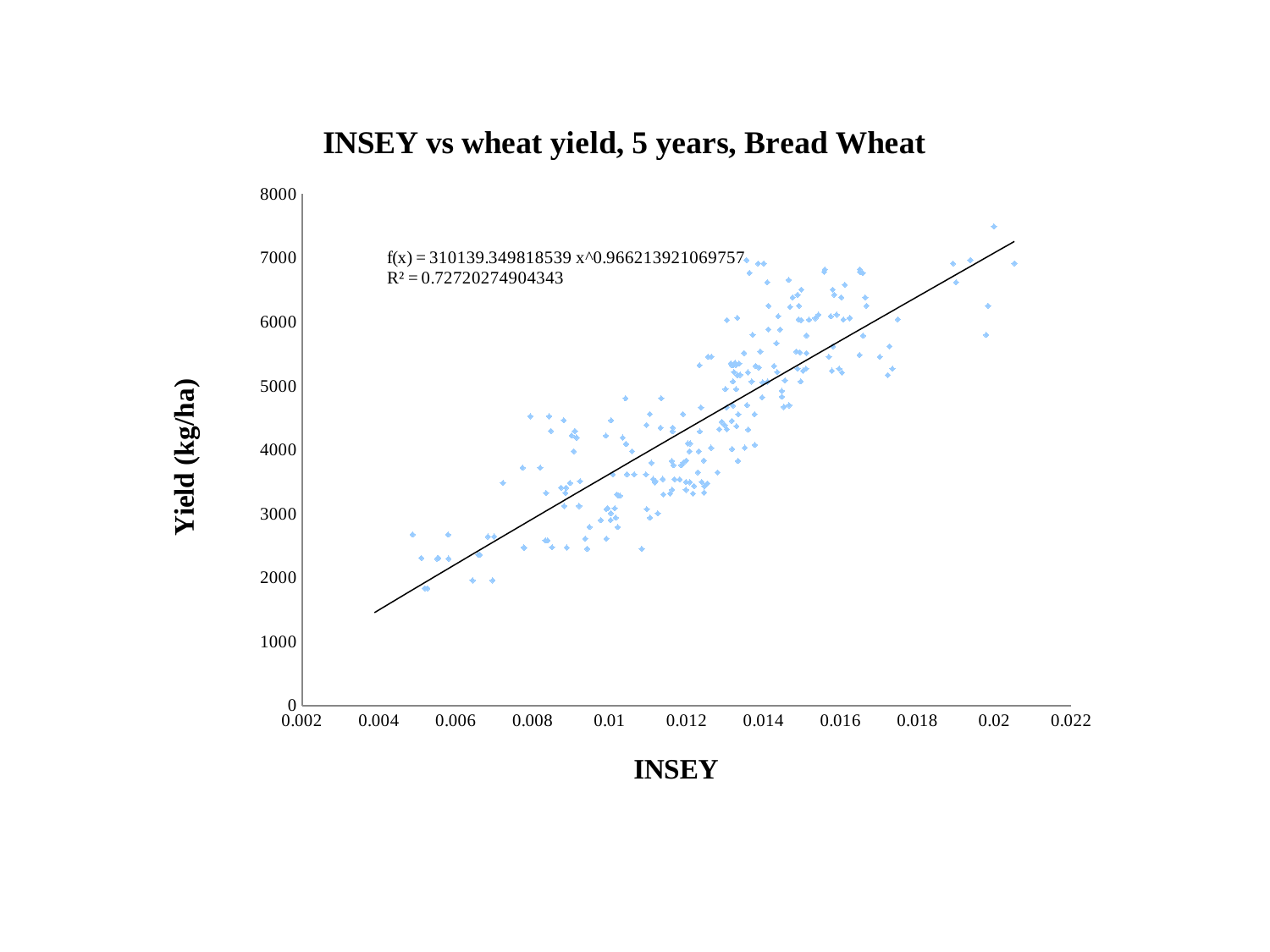
What is the title of the chart? INSEY vs wheat yield, 5 years, Bread Wheat Is the yield of the lowest plotted point greater or less than 3000? less What is the highest value shown on the vertical axis? 8000 What R² value is printed on the chart? R² = 0.72720274904343 Is the yield of the point with the largest INSEY value (around 0.0205) greater or less than 6000? greater What is the highest value shown on the horizontal axis? 0.022 What kind of chart is shown on the slide? scatter chart What is the label of the vertical axis? Yield (kg/ha) Is the yield of the highest plotted point greater or less than 7000? greater What trendline equation is printed on the chart? f(x) = 310139.349818539 x^0.966213921069757 Do the plotted yield values generally rise or fall as INSEY increases along the x axis? rise